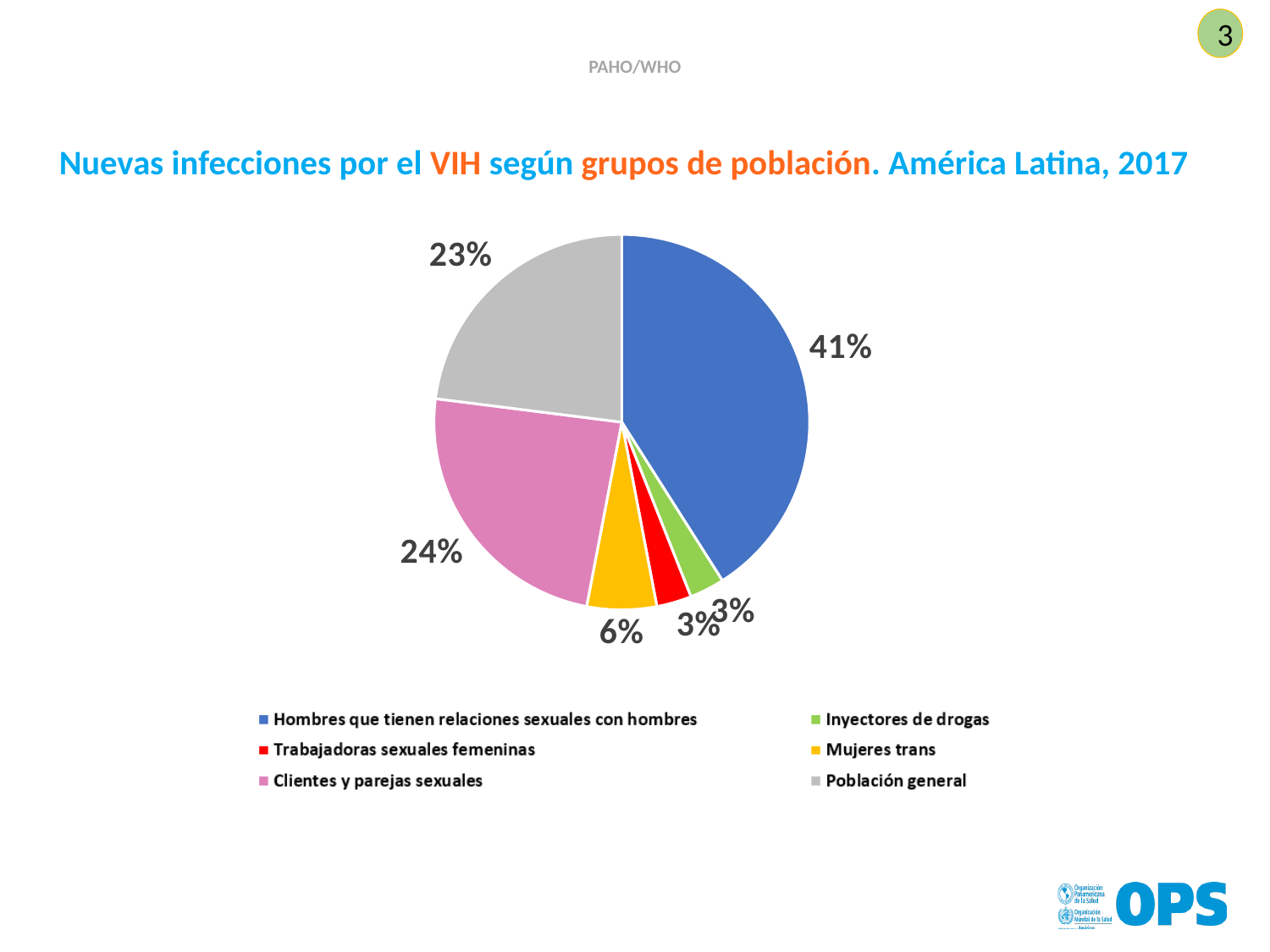
What percentage is shown for 'Clientes y parejas sexuales'? 24% What is the difference in percentage points between 'Mujeres trans' and 'Trabajadoras sexuales femeninas'? 3 Which colour represents 'Población general' in the pie chart? Gray What type of chart is shown on the slide? Pie chart What is the difference in percentage points between 'Hombres que tienen relaciones sexuales con hombres' and 'Clientes y parejas sexuales'? 17 What is the title of the chart? Nuevas infecciones por el VIH según grupos de población. América Latina, 2017 How many population groups are shown in the pie chart? 6 What share of new HIV infections is attributed to 'Hombres que tienen relaciones sexuales con hombres'? 41% Which population group has the largest slice of the pie? Hombres que tienen relaciones sexuales con hombres What share of the pie corresponds to 'Población general'? 23% Which group has the larger share: 'Clientes y parejas sexuales' or 'Población general'? Clientes y parejas sexuales What percentage is shown for 'Mujeres trans'? 6%